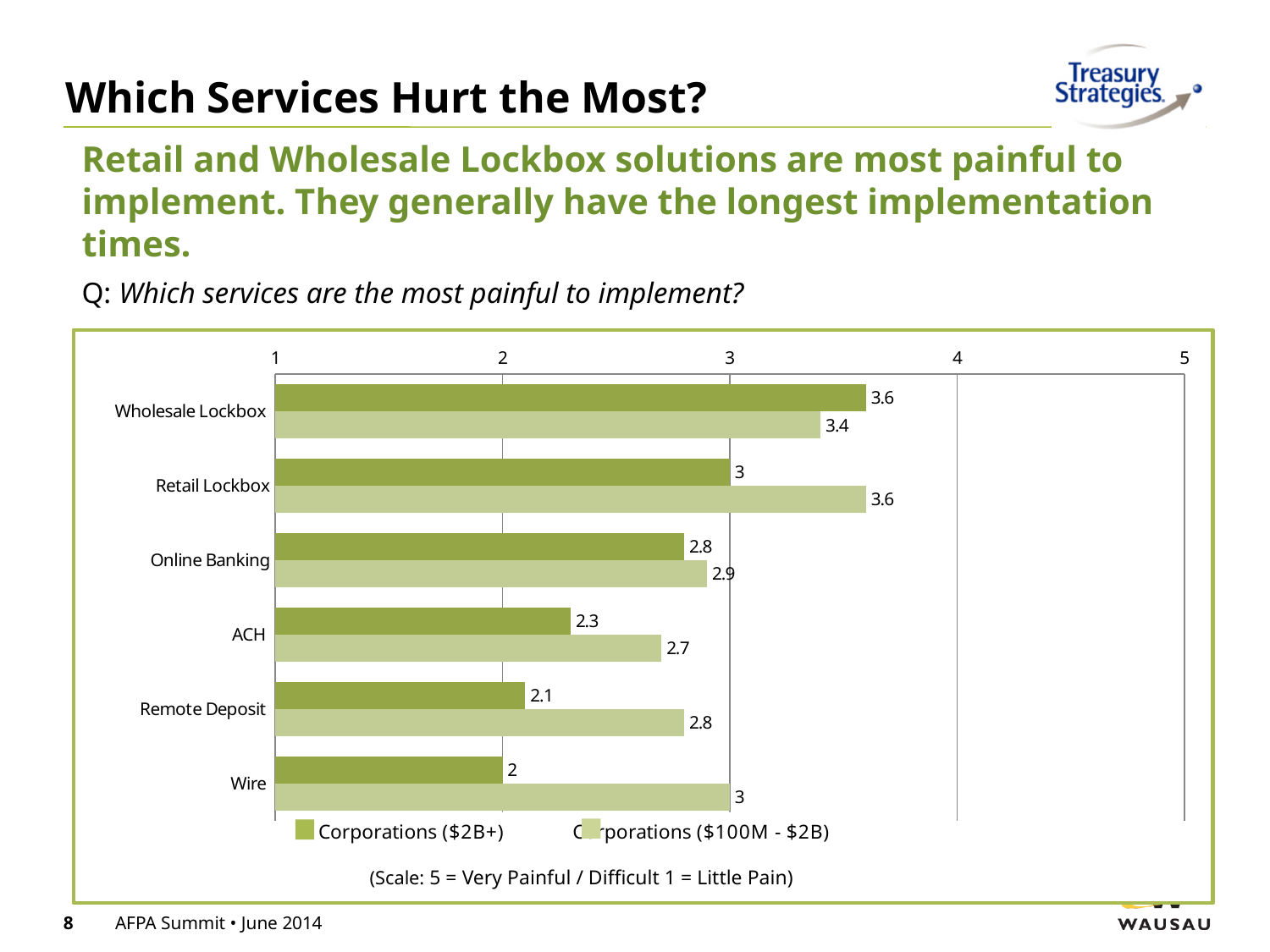
Which service has the lowest value for Corporations ($2B+)? Wire How many series does the legend list? 2 What is the value for Remote Deposit for Corporations ($100M - $2B)? 2.8 What kind of chart is shown on the slide? Bar chart Which service has the lowest value for Corporations ($100M - $2B)? ACH For ACH, which is larger: the value for Corporations ($2B+) or for Corporations ($100M - $2B)? Corporations ($100M - $2B) What is the value for Retail Lockbox for Corporations ($100M - $2B)? 3.6 What is the value for Wire for Corporations ($2B+)? 2 What is the value for Wholesale Lockbox for Corporations ($2B+)? 3.6 What is the difference between the Corporations ($100M - $2B) and Corporations ($2B+) values for Remote Deposit? 0.7 Which service has the highest value for Corporations ($2B+)? Wholesale Lockbox How many services are shown on the chart? 6